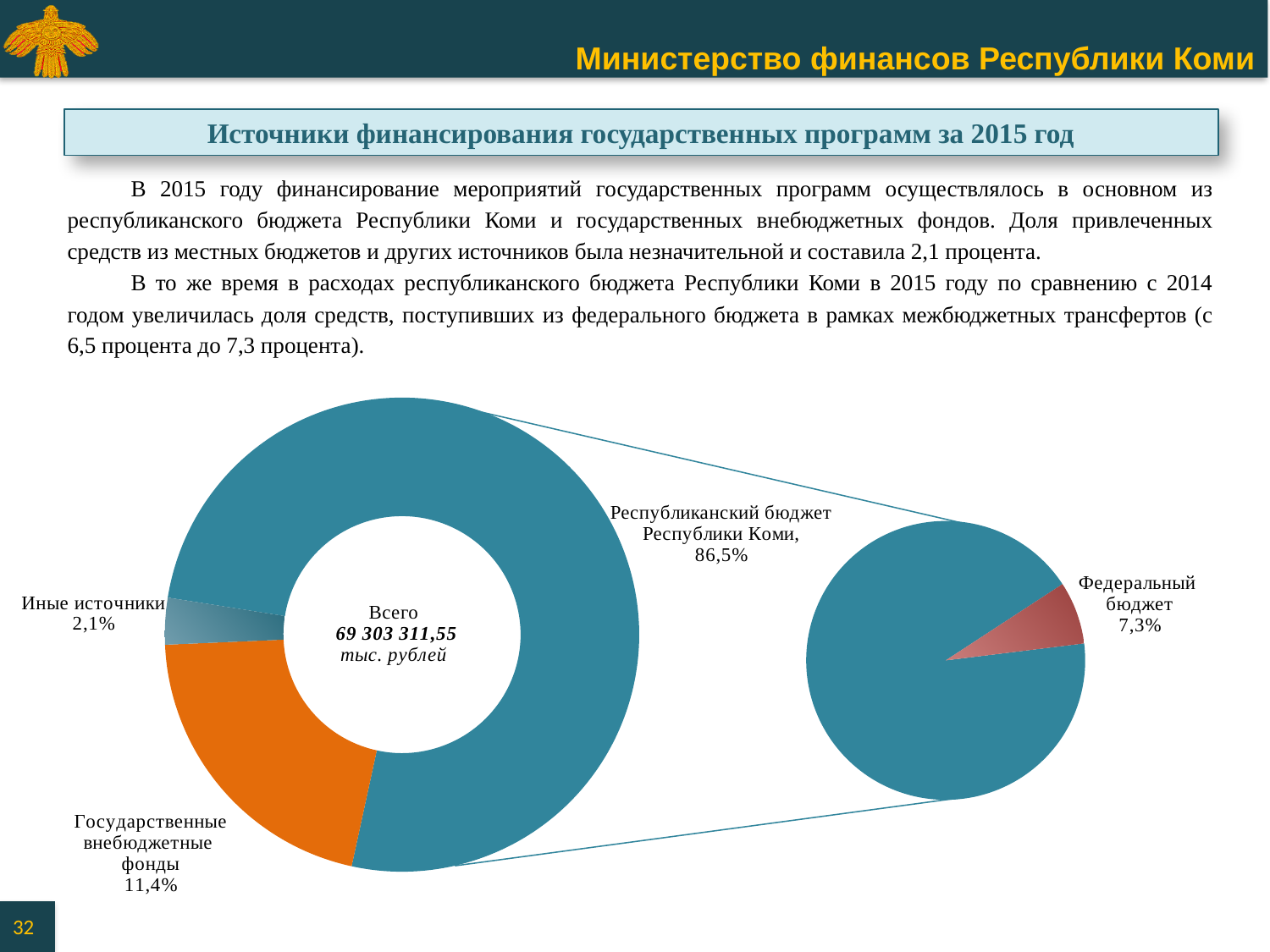
What total value is printed in the centre of the donut chart? 69 303 311,55 тыс. рублей How many slices does the main donut chart have? 3 What share of the main donut chart is labelled "Республиканский бюджет Республики Коми"? 86,5% What share of the main donut chart is labelled "Государственные внебюджетные фонды"? 11,4% Which source has the smallest share in the main donut chart? Иные источники What is the difference in percentage points between "Государственные внебюджетные фонды" and "Иные источники"? 9,3 What is the title of the slide above the chart? Источники финансирования государственных программ за 2015 год What type of chart is shown on the slide? Donut (pie) chart Which is larger: the share of "Государственные внебюджетные фонды" or the share of "Федеральный бюджет"? Государственные внебюджетные фонды What share of the main donut chart is labelled "Иные источники"? 2,1% Which source has the largest share in the main donut chart? Республиканский бюджет Республики Коми What share is shown for "Федеральный бюджет" in the smaller pie on the right? 7,3%